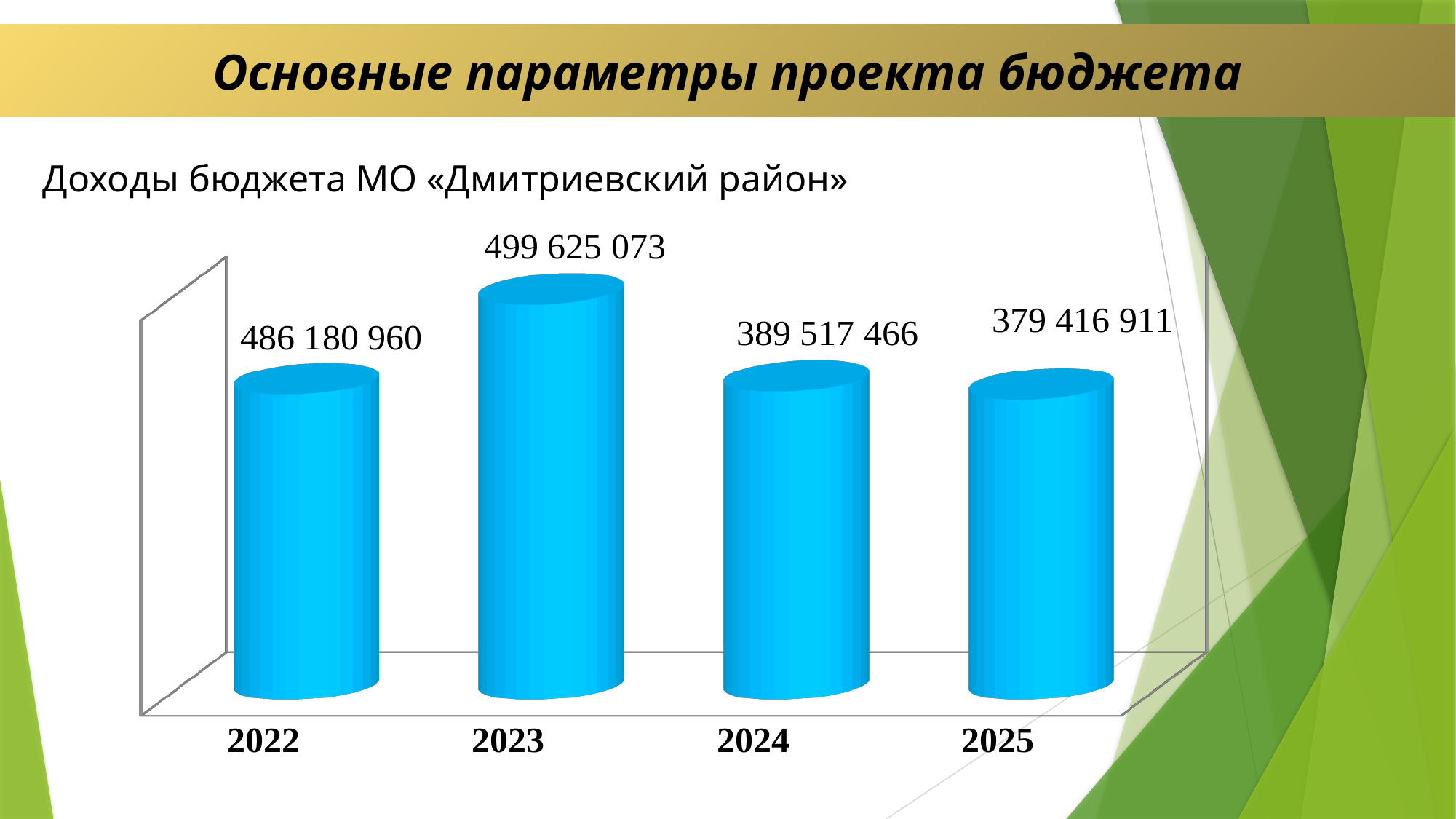
What is the difference between the values for 2024 and 2025? 10 100 555 What is the value for 2023? 499 625 073 Do the values rise or fall from 2023 to 2025? Fall How many years are shown on the chart? 4 Which year has the highest value? 2023 What kind of chart is shown on the slide? Bar chart What is the value for 2022? 486 180 960 What is the difference between the values for 2023 and 2022? 13 444 113 Which is larger, the value for 2022 or the value for 2024? 2022 What is the value for 2025? 379 416 911 Which year has the lowest value? 2025 What is the value for 2024? 389 517 466